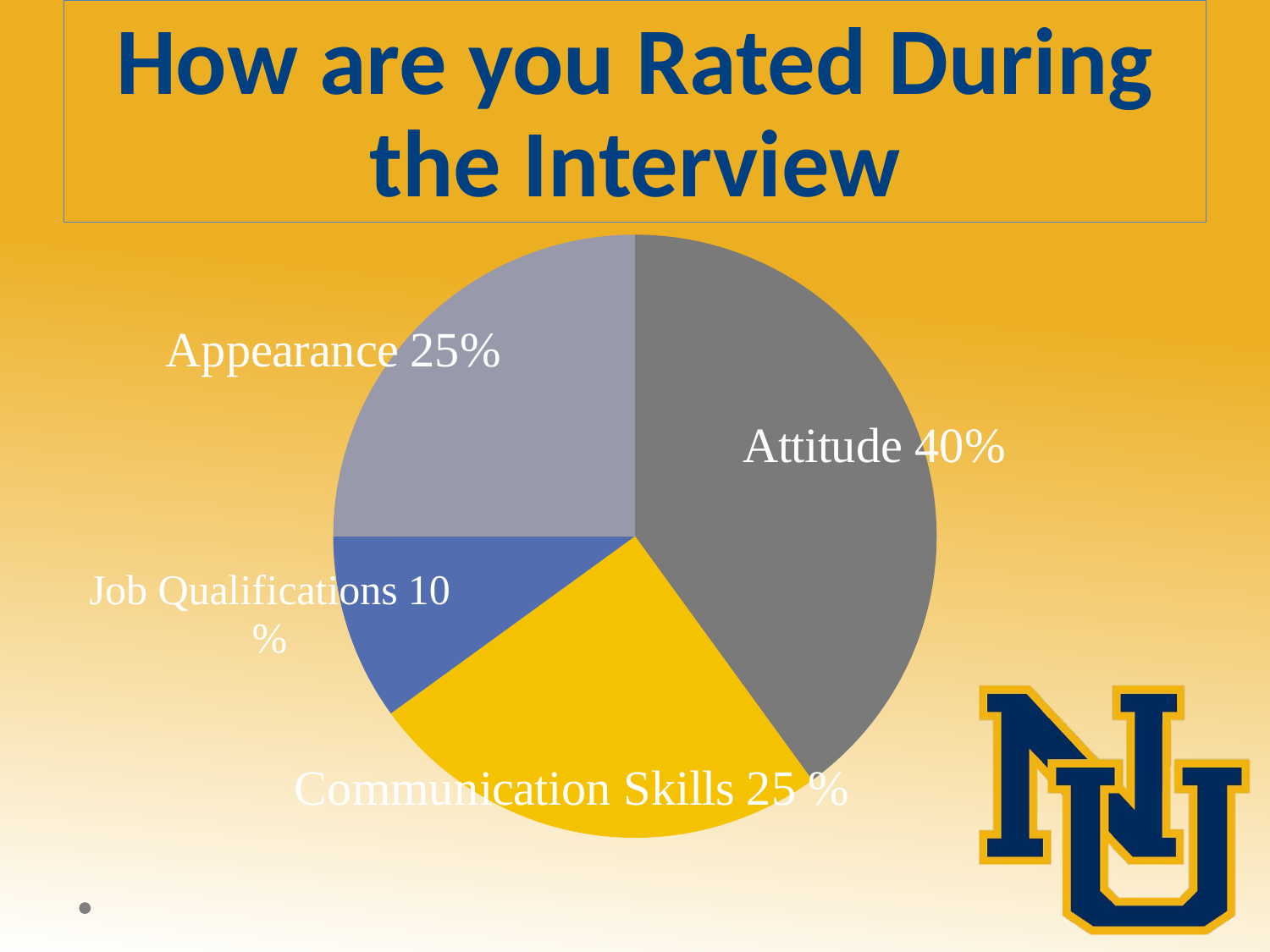
What is the difference between the Attitude and Job Qualifications percentages? 30% What percentage is shown for Communication Skills? 25% What percentage is shown for Appearance? 25% What kind of chart is shown on the slide? Pie chart Which category has the smallest share of the pie? Job Qualifications What percentage is shown for Attitude? 40% What percentage is shown for Job Qualifications? 10% What colour is the Communication Skills slice? Yellow How many categories are shown in the pie chart? 4 Which is larger, the share for Attitude or the share for Appearance? Attitude What is the title of the slide containing the pie chart? How are you Rated During the Interview Which category has the largest share of the pie? Attitude